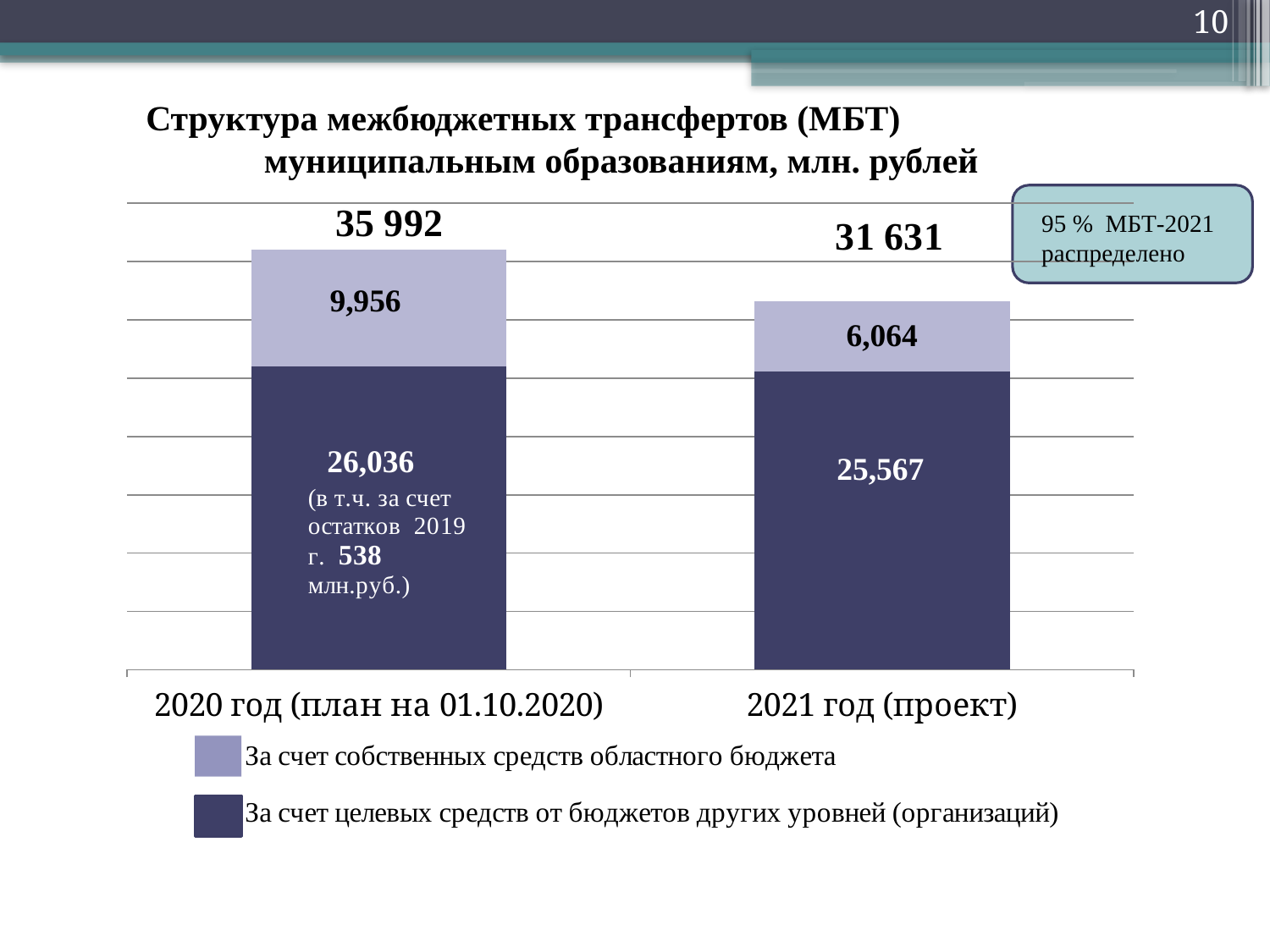
How many categories are shown on the x axis? 2 Which is larger: 'За счет целевых средств от бюджетов других уровней (организаций)' in 2020 or in 2021? 2020 год (план на 01.10.2020) How many series does the legend list? 2 What is the total of the stacked bar for 2021 год (проект)? 31 631 Which series is shown in the darker colour in the legend? За счет целевых средств от бюджетов других уровней (организаций) Which category has the higher total? 2020 год (план на 01.10.2020) What is the total of the stacked bar for 2020 год (план на 01.10.2020)? 35 992 What type of chart is shown on the slide? stacked bar chart What is the value for 'За счет целевых средств от бюджетов других уровней (организаций)' in 2021 год (проект)? 25,567 What is the value for 'За счет собственных средств областного бюджета' in 2021 год (проект)? 6,064 What is the difference between the 'За счет собственных средств областного бюджета' values for 2020 and 2021? 3,892 What is the value for 'За счет собственных средств областного бюджета' in 2020 год (план на 01.10.2020)? 9,956